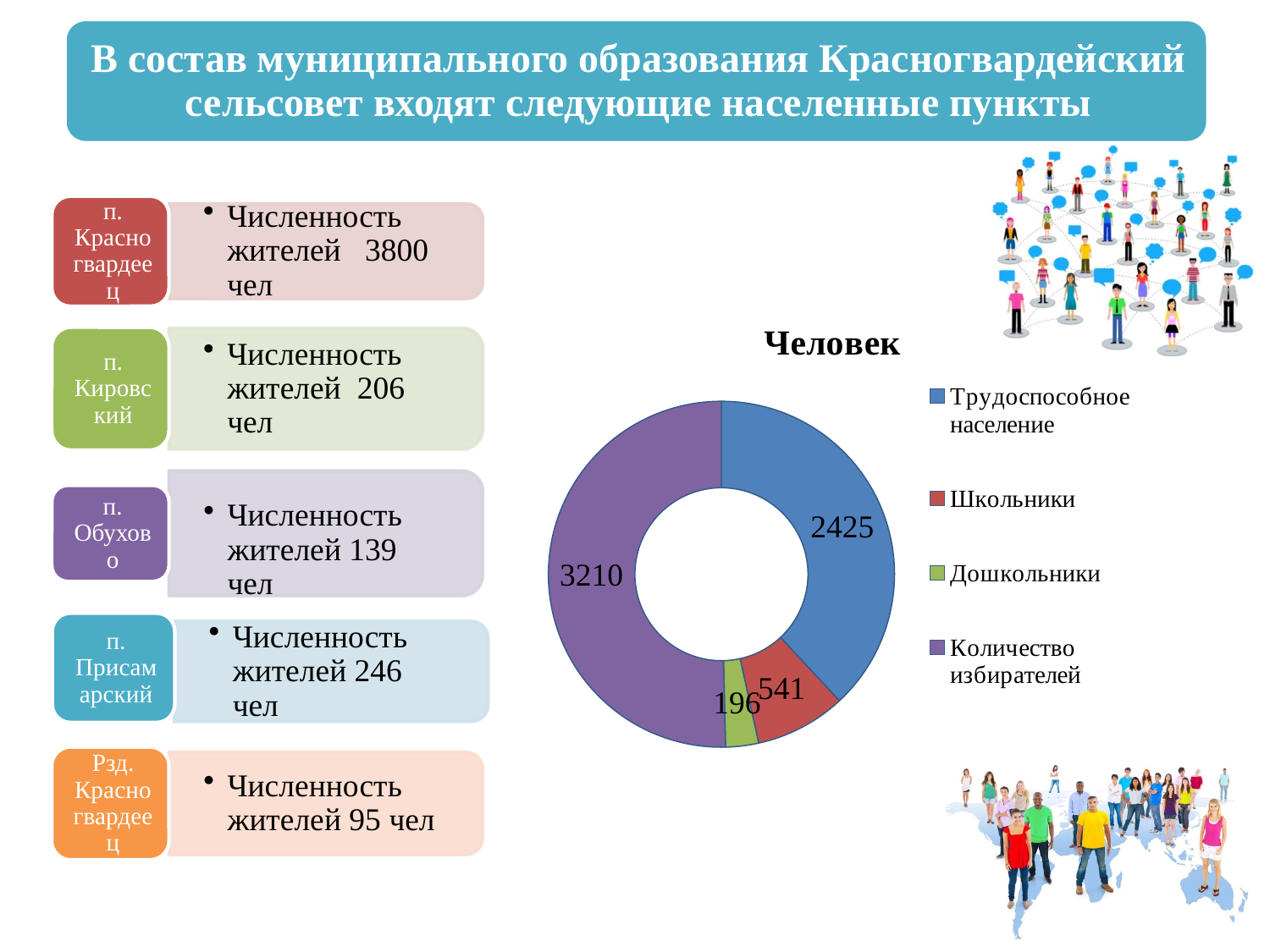
What is the title of the chart? Человек Which category has the smallest value? Дошкольники What is the value for Количество избирателей? 3210 How many categories does the legend list? 4 Which category has the largest value? Количество избирателей Which is larger, Школьники or Дошкольники? Школьники What is the value for Дошкольники? 196 What kind of chart is shown on the slide? Doughnut (pie) chart What is the value for Школьники? 541 What is the difference between Количество избирателей and Трудоспособное население? 785 What is the value for Трудоспособное население? 2425 What is the total of all four values in the chart? 6372